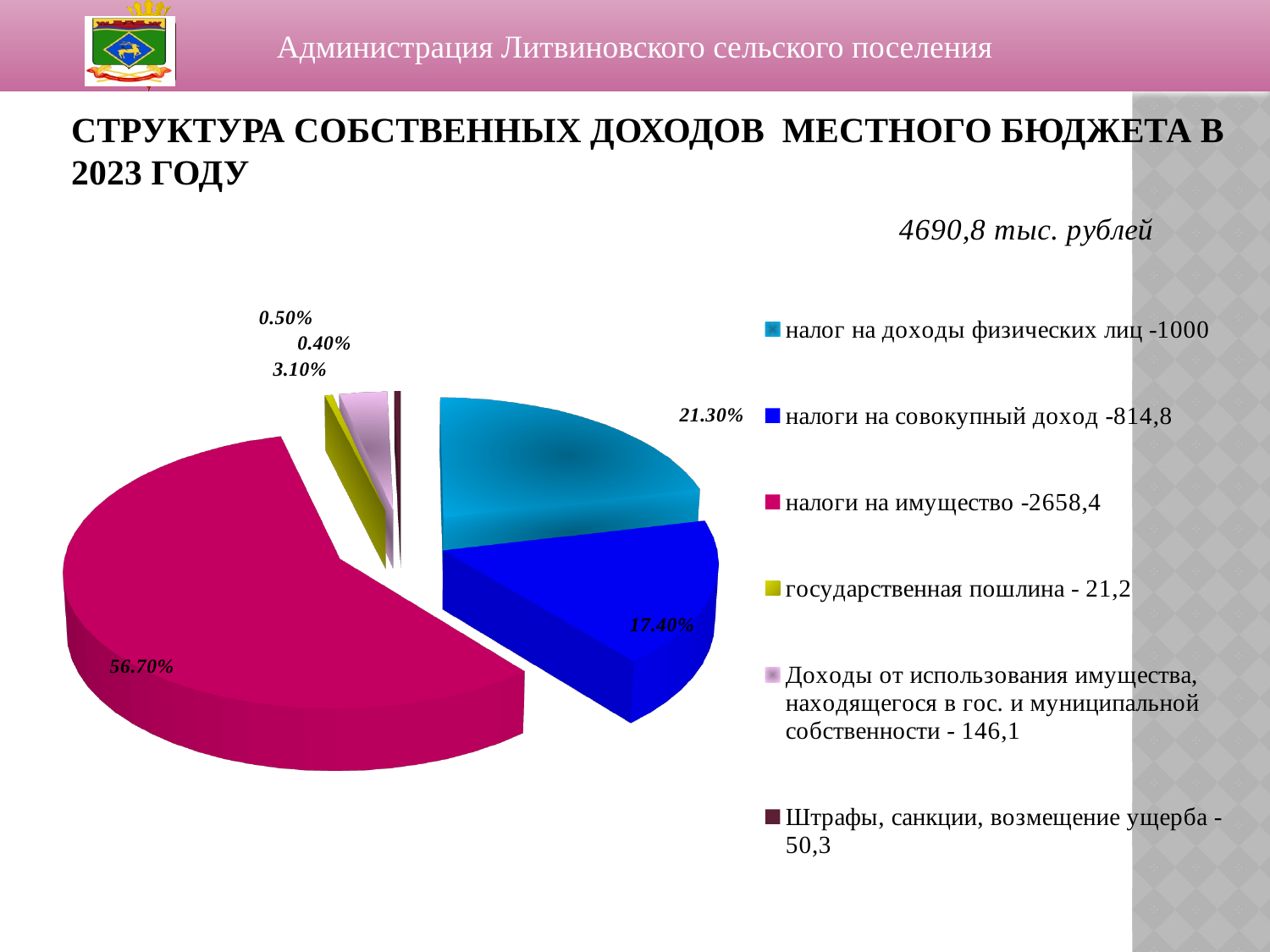
What total amount in thousand rubles is stated above the pie chart? 4690,8 тыс. рублей What kind of chart is shown on the slide? pie chart What share of the pie does налоги на имущество account for? 56.70% According to the legend, what amount is given for налоги на имущество? 2658,4 What is the difference in percentage points between the share for налоги на имущество and the share for налог на доходы физических лиц? 35.40% What share of the pie does налог на доходы физических лиц account for? 21.30% Which is larger: the share for налог на доходы физических лиц or the share for налоги на совокупный доход? налог на доходы физических лиц How many entries does the legend of the pie chart list? 6 Which category has the largest share of the pie chart? налоги на имущество What share of the pie does налоги на совокупный доход account for? 17.40% What is the smallest percentage label shown on the pie chart? 0.40% How many slices does the pie chart have? 6